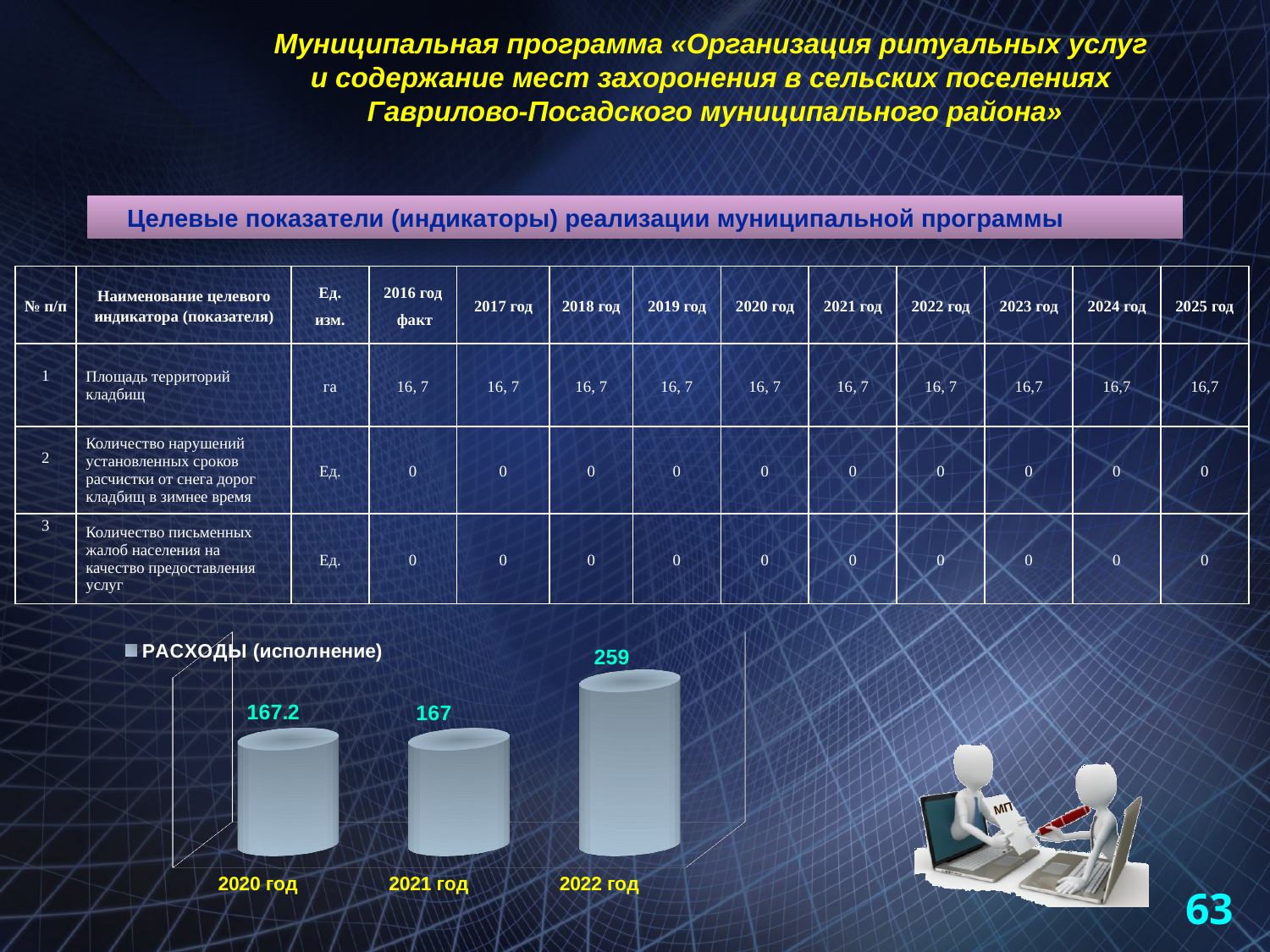
Which is larger, the value for 2022 год or the value for 2020 год? 2022 год What is the difference between the values for 2020 год and 2021 год? 0.2 What kind of chart is shown on the slide? bar chart What is the value for 2022 год in the chart? 259 What is the name of the series in the chart legend? РАСХОДЫ (исполнение) Which year has the lowest value in the chart? 2021 год What is the value for 2021 год in the chart? 167 How many series does the chart legend list? 1 What is the difference between the values for 2022 год and 2021 год? 92 Which year has the highest value in the chart? 2022 год How many years are shown in the chart? 3 What is the value for 2020 год in the chart? 167.2